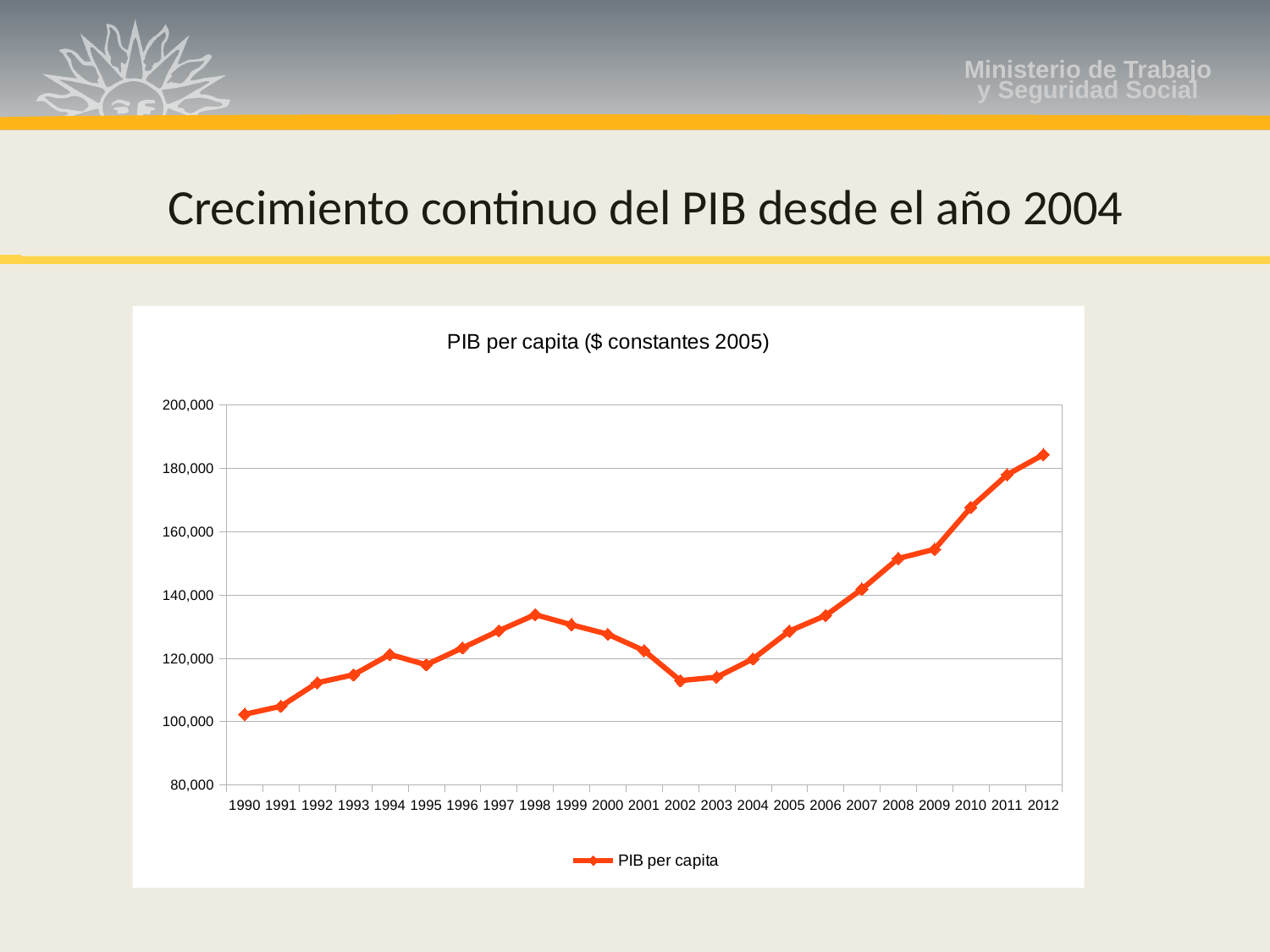
Is the value for 1990 greater or less than 120,000? less Which year has the lowest PIB per capita value? 1990 Which year has the highest PIB per capita value? 2012 What is the title of the chart? PIB per capita ($ constantes 2005) Is the value for 2008 greater or less than 160,000? less Which year has a larger PIB per capita value, 1998 or 2002? 1998 What kind of chart is shown on the slide? line chart How many years are plotted along the x axis? 23 How many series does the legend list? 1 Do the values rise or fall from 2004 to 2012? rise Do the values rise or fall from 1998 to 2002? fall Is the value for 2012 greater or less than 180,000? greater